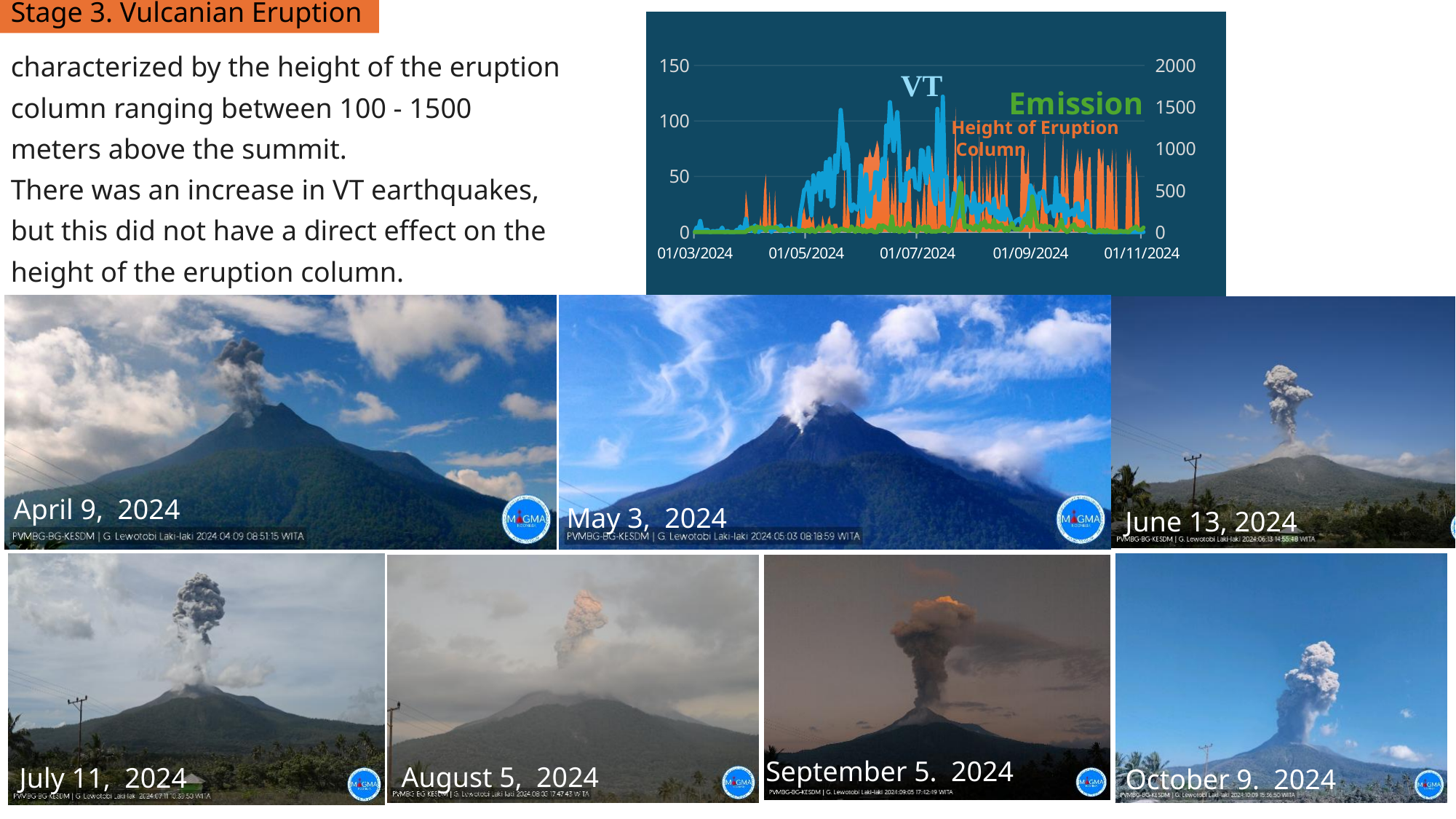
Which series is drawn in blue on the chart? VT What kind of chart is shown on the slide? combination area and line chart What is the maximum value shown on the right y axis of the chart? 2000 Which series is drawn in green on the chart? Emission Is the VT series value around 01/03/2024 greater or less than 50 on the left axis? less How many date labels are shown on the x axis of the chart? 5 What is the maximum value shown on the left y axis of the chart? 150 What is the first date shown on the x axis of the chart? 01/03/2024 Is the peak value of the VT series greater or less than 100 on the left axis? greater How many series does the chart show? 3 What is the last date shown on the x axis of the chart? 01/11/2024